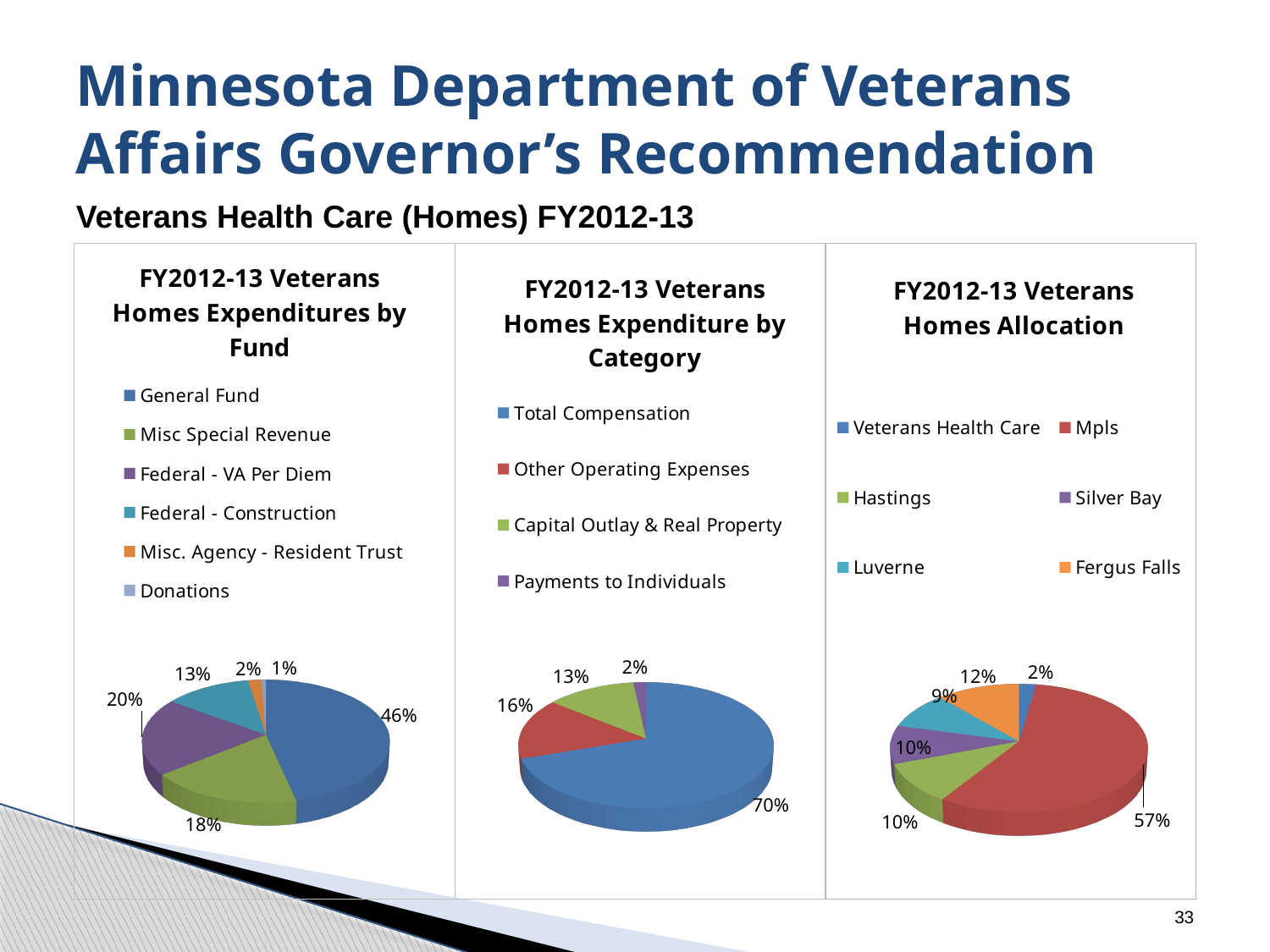
In the 'FY2012-13 Veterans Homes Expenditure by Category' chart, what share does Total Compensation have? 70% In the 'FY2012-13 Veterans Homes Expenditure by Category' chart, what is the difference between Other Operating Expenses and Capital Outlay & Real Property? 3% In the 'FY2012-13 Veterans Homes Allocation' chart, what share does Fergus Falls have? 12% In the 'FY2012-13 Veterans Homes Allocation' chart, which is larger, Luverne or Fergus Falls? Fergus Falls In the 'FY2012-13 Veterans Homes Expenditures by Fund' chart, what share does Federal - VA Per Diem have? 20% What type of chart is the 'FY2012-13 Veterans Homes Expenditure by Category' chart? Pie chart In the 'FY2012-13 Veterans Homes Expenditures by Fund' chart, which fund has the smallest share? Donations In the 'FY2012-13 Veterans Homes Allocation' chart, what share does Mpls have? 57% How many pie charts are shown on the slide? 3 In the 'FY2012-13 Veterans Homes Expenditure by Category' chart, which category has the smallest share? Payments to Individuals In the 'FY2012-13 Veterans Homes Expenditures by Fund' chart, what share does the General Fund have? 46% In the 'FY2012-13 Veterans Homes Expenditures by Fund' chart, how many funds does the legend list? 6